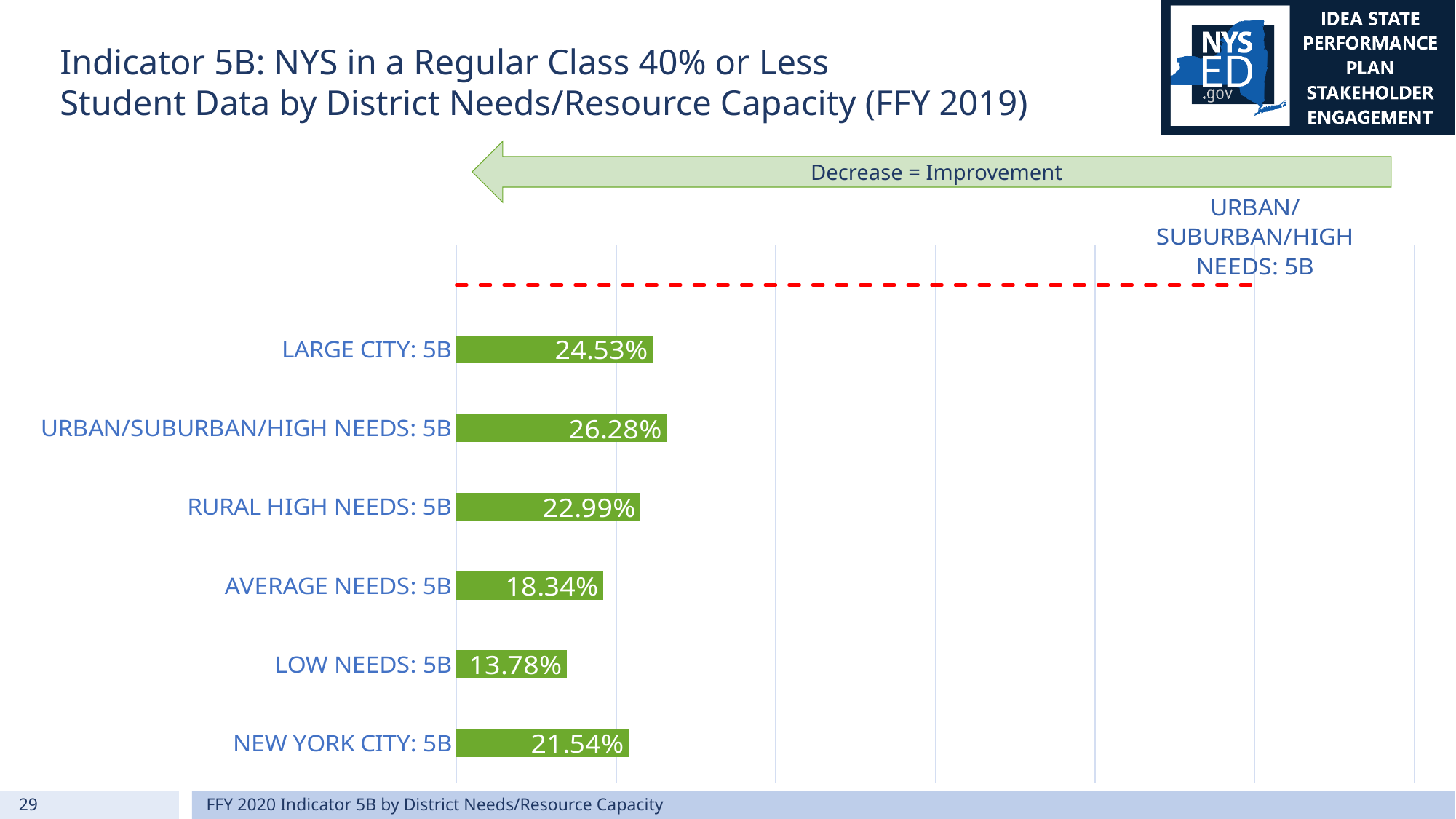
What does the green arrow above the chart say? Decrease = Improvement Which category has the highest value? URBAN/SUBURBAN/HIGH NEEDS: 5B What is the value for RURAL HIGH NEEDS: 5B? 22.99% Which is larger, the value for AVERAGE NEEDS: 5B or the value for NEW YORK CITY: 5B? NEW YORK CITY: 5B What is the value for LOW NEEDS: 5B? 13.78% What is the value for NEW YORK CITY: 5B? 21.54% What is the difference between the values for NEW YORK CITY: 5B and LOW NEEDS: 5B? 7.76 percentage points Which category has the lowest value? LOW NEEDS: 5B What is the value for LARGE CITY: 5B? 24.53% What is the difference between the values for URBAN/SUBURBAN/HIGH NEEDS: 5B and LARGE CITY: 5B? 1.75 percentage points How many categories are shown in the chart? 6 What kind of chart is shown on the slide? Bar chart